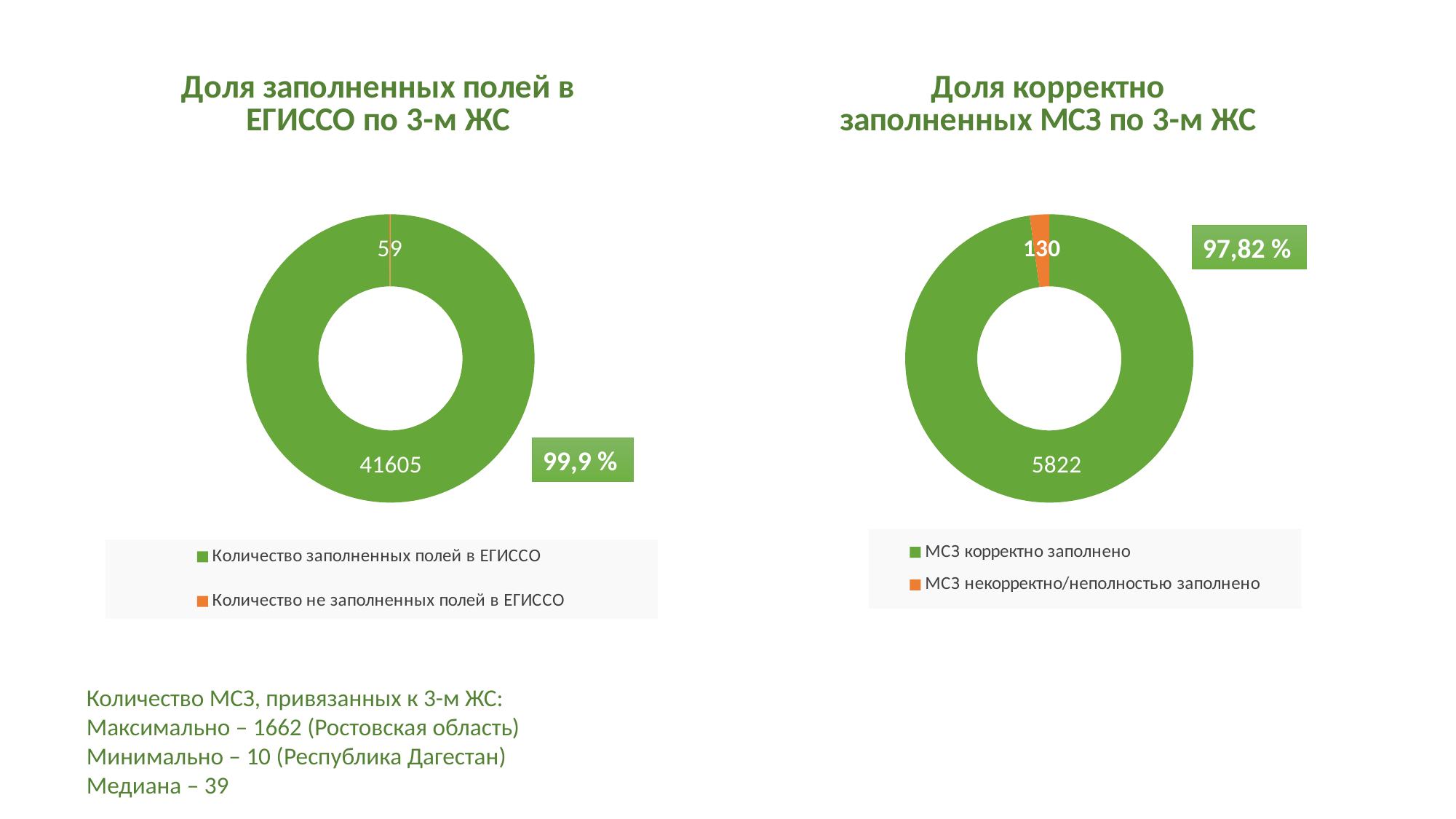
In the left chart (Доля заполненных полей в ЕГИССО по 3-м ЖС), what is the value for Количество заполненных полей в ЕГИССО? 41605 In the left chart (Доля заполненных полей в ЕГИССО по 3-м ЖС), what is the value for Количество не заполненных полей в ЕГИССО? 59 In the right chart (Доля корректно заполненных МСЗ по 3-м ЖС), what is the value for МСЗ корректно заполнено? 5822 In the right chart (Доля корректно заполненных МСЗ по 3-м ЖС), what is the difference between МСЗ корректно заполнено and МСЗ некорректно/неполностью заполнено? 5692 In the right chart (Доля корректно заполненных МСЗ по 3-м ЖС), which category has the smallest value? МСЗ некорректно/неполностью заполнено In the right chart (Доля корректно заполненных МСЗ по 3-м ЖС), what is the value for МСЗ некорректно/неполностью заполнено? 130 In the left chart (Доля заполненных полей в ЕГИССО по 3-м ЖС), what is the total of the two categories? 41664 In the left chart (Доля заполненных полей в ЕГИССО по 3-м ЖС), what share of the total is shown for the filled fields (Количество заполненных полей в ЕГИССО)? 99,9 % In the right chart (Доля корректно заполненных МСЗ по 3-м ЖС), what share is shown for МСЗ корректно заполнено? 97,82 % What kind of chart is the right chart (Доля корректно заполненных МСЗ по 3-м ЖС)? Doughnut (pie) chart In the left chart (Доля заполненных полей в ЕГИССО по 3-м ЖС), which category has the largest value? Количество заполненных полей в ЕГИССО How many entries does the legend of the left chart (Доля заполненных полей в ЕГИССО по 3-м ЖС) list? 2